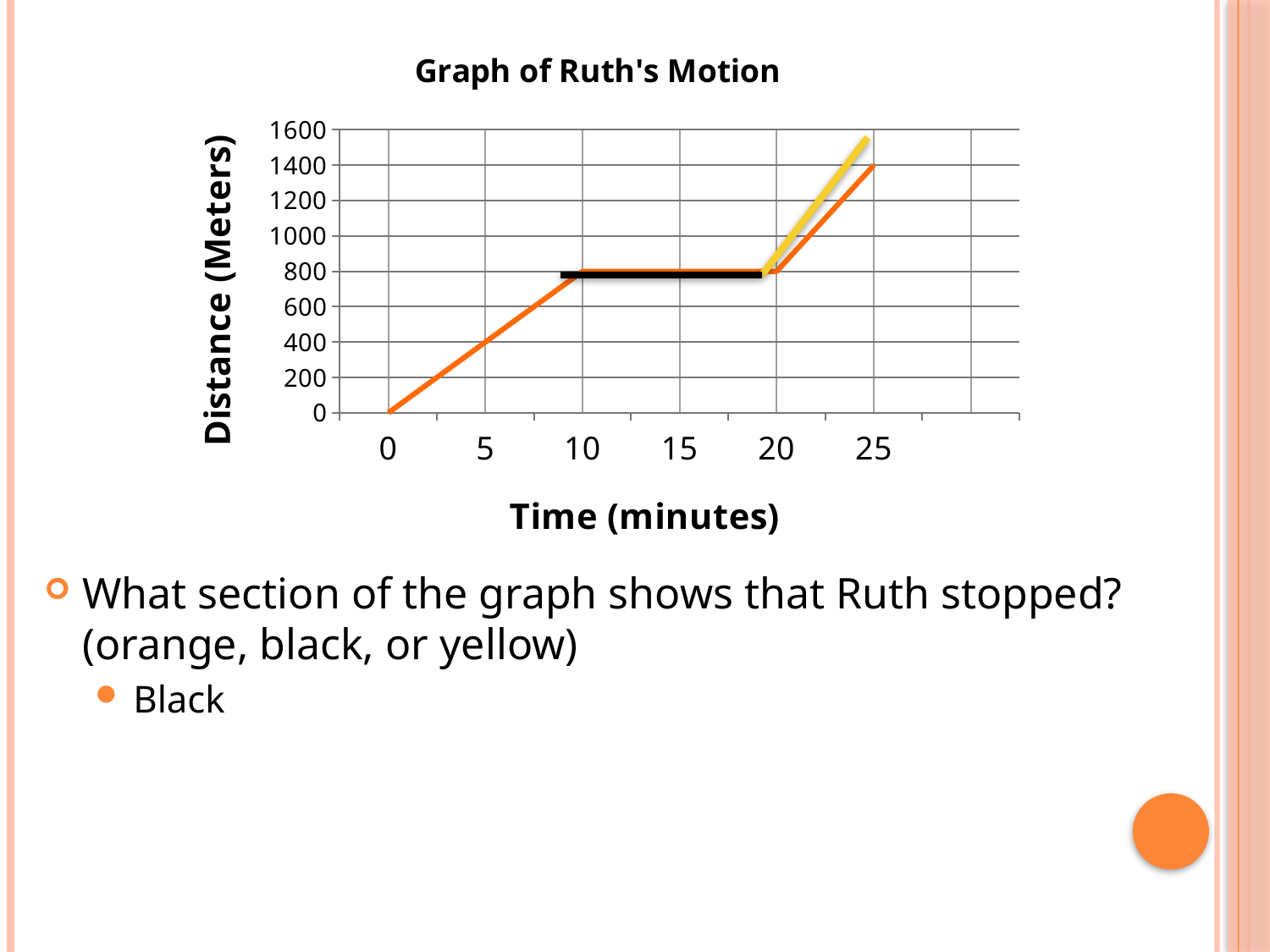
Is the distance at 25 minutes greater or less than 1000? greater What kind of chart is shown on the slide? line chart Does the distance rise or fall as time increases from 0 to 25 minutes? rise Is the distance at 25 minutes larger or smaller than the distance at 10 minutes? larger Is the distance at 15 minutes greater or less than 1000? less What is the title of the chart? Graph of Ruth's Motion What is the highest value shown on the Distance (Meters) axis? 1600 What is the distance at time 0 minutes? 0 At what distance does the flat (black) section of the graph sit? 800 Is the distance at 5 minutes greater or less than 600? less Which coloured section of the graph is flat, showing no change in distance? black